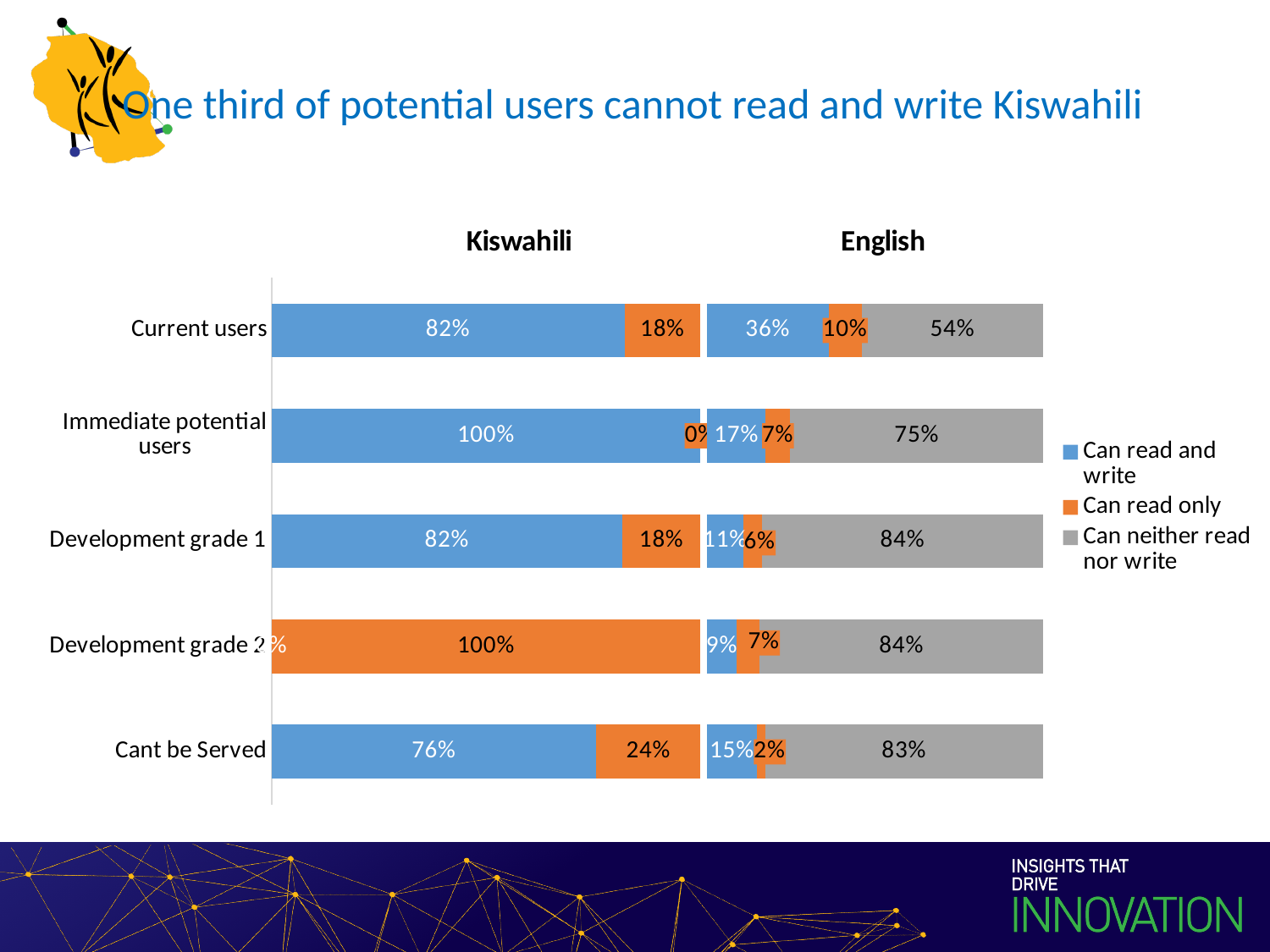
How many series does the legend list? 3 In the English chart, what percentage of Immediate potential users can read and write? 17% In the Kiswahili chart, what percentage of Current users can read and write? 82% Which series is shown in grey in the legend? Can neither read nor write What kind of chart is used on this slide? Stacked bar chart In the English chart, which category has the highest share that can read and write? Current users In the English chart, what percentage of Current users can neither read nor write? 54% In the English chart, which category has the lowest share that can neither read nor write? Current users In the Kiswahili chart, what percentage of the Cant be Served group can read only? 24% In the English chart, which is larger: the 'Can read only' share for Current users or for Development grade 1? Current users How many categories are shown on the y axis of the charts? 5 In the Kiswahili chart, what is the difference between the 'Can read and write' share for Current users and for Cant be Served? 6%